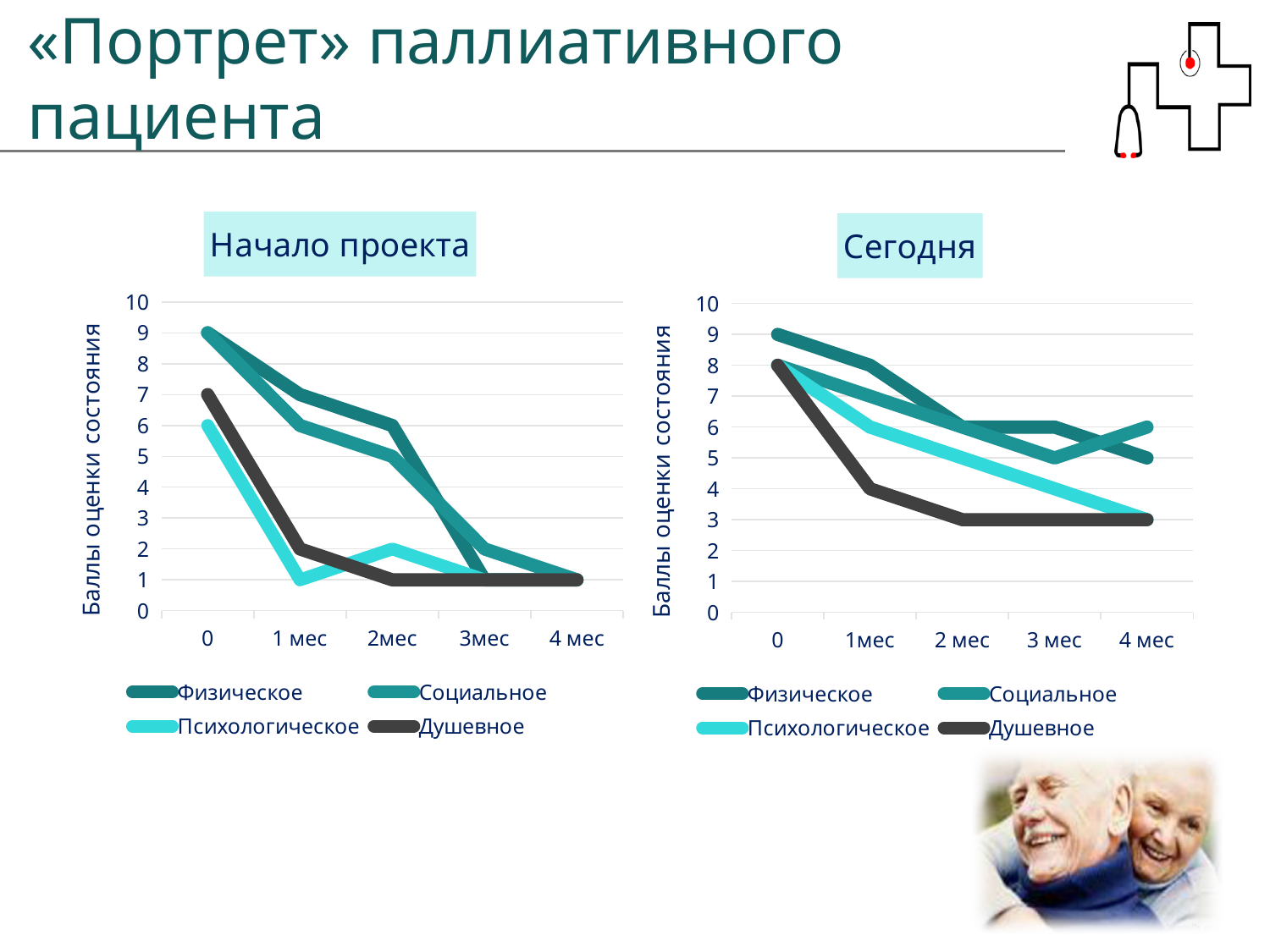
In the "Начало проекта" chart, what is the value for Душевное at 0? 7 In the "Сегодня" chart, which is larger at 1мес: Физическое or Душевное? Физическое How many points are on the x axis of the "Начало проекта" chart? 5 In the "Начало проекта" chart, what is the difference between the Душевное values at 0 and at 1 мес? 5 How many series does the legend of the "Сегодня" chart list? 4 In the "Сегодня" chart, does the Душевное series rise or fall from 0 to 4 мес? fall In the "Сегодня" chart, which series is highest at 1мес? Физическое In the "Начало проекта" chart, which series is lowest at 1 мес? Психологическое In the "Сегодня" chart, what is the value for Душевное at 4 мес? 3 What kind of chart is the "Начало проекта" chart? line chart What is the y-axis label of the "Сегодня" chart? Баллы оценки состояния In the "Начало проекта" chart, what is the value for Психологическое at 0? 6